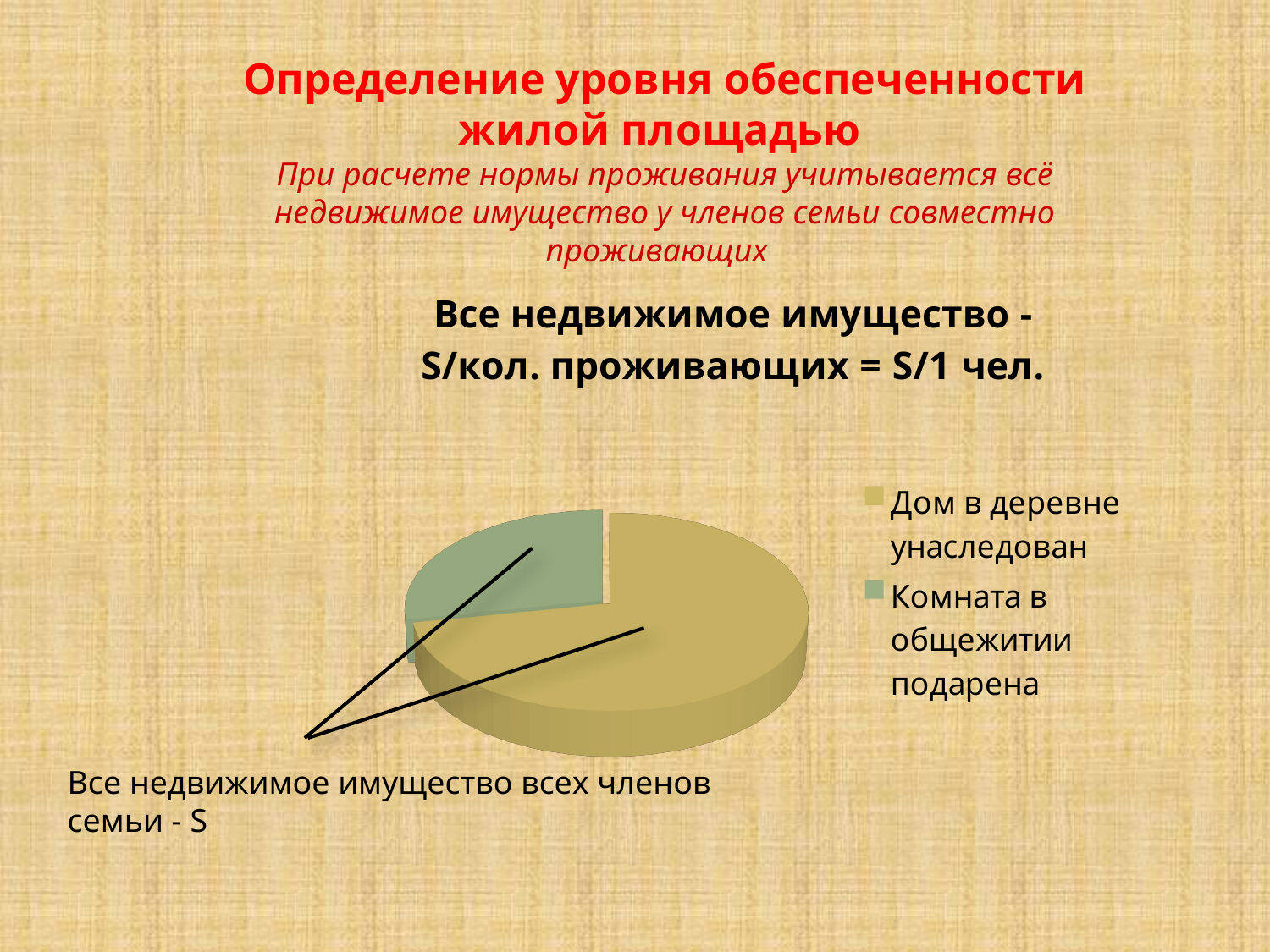
Which slice of the pie chart is the largest? Дом в деревне унаследован What colour is the slice for "Комната в общежитии подарена" in the pie chart? green How many entries does the legend of the pie chart list? 2 What is the first entry listed in the legend of the pie chart? Дом в деревне унаследован What kind of chart is shown on the slide? pie chart Which is larger in the pie chart: the slice for "Дом в деревне унаследован" or the slice for "Комната в общежитии подарена"? Дом в деревне унаследован Does the slice for "Дом в деревне унаследован" take up more or less than half of the pie? more How many slices does the pie chart have? 2 Does the slice for "Комната в общежитии подарена" take up more or less than half of the pie? less Which slice of the pie chart is the smallest? Комната в общежитии подарена